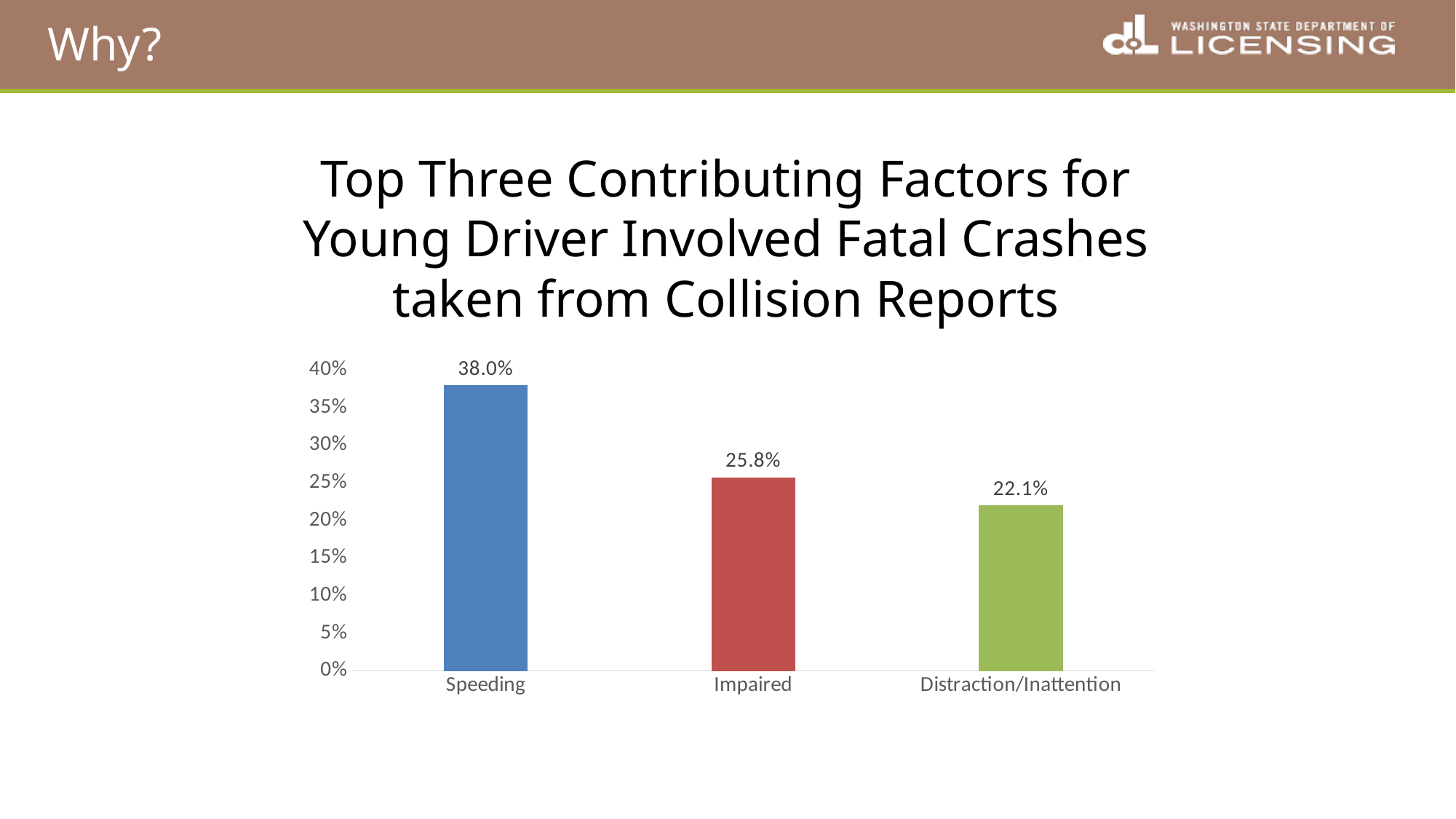
How many contributing factors are shown in the chart? 3 What colour is the bar for Impaired? red What is the value for Impaired? 25.8% Is the value for Speeding greater or less than 35%? greater Which is larger, the value for Impaired or the value for Distraction/Inattention? Impaired What is the difference between the values for Speeding and Impaired? 12.2% Which contributing factor has the highest value? Speeding What is the value for Distraction/Inattention? 22.1% What is the difference between the values for Impaired and Distraction/Inattention? 3.7% Which contributing factor has the lowest value? Distraction/Inattention What kind of chart is shown on the slide? bar chart What is the value for Speeding? 38.0%